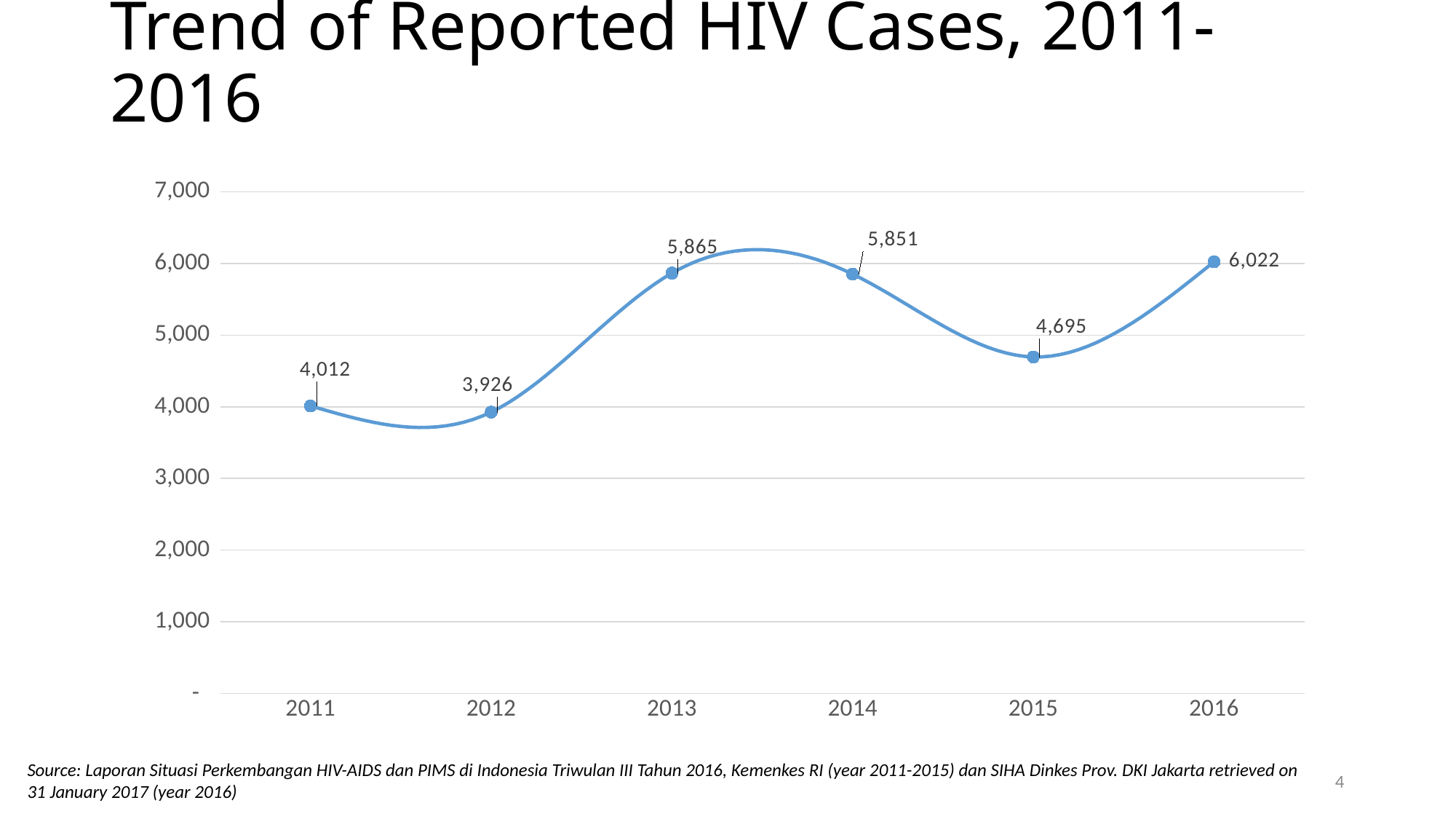
What is the number of reported HIV cases in 2011? 4,012 What is the difference between the reported HIV cases in 2013 and 2012? 1,939 Which year has the lowest number of reported HIV cases? 2012 What kind of chart is shown on the slide? line chart What is the difference between the reported HIV cases in 2016 and 2015? 1,327 How many years are plotted on the chart? 6 What is the number of reported HIV cases in 2013? 5,865 Which year has the highest number of reported HIV cases? 2016 Is the value for 2014 greater or less than 5,000? greater Which year has more reported HIV cases, 2014 or 2015? 2014 Do the reported HIV cases rise or fall from 2011 to 2013? rise What is the number of reported HIV cases in 2015? 4,695